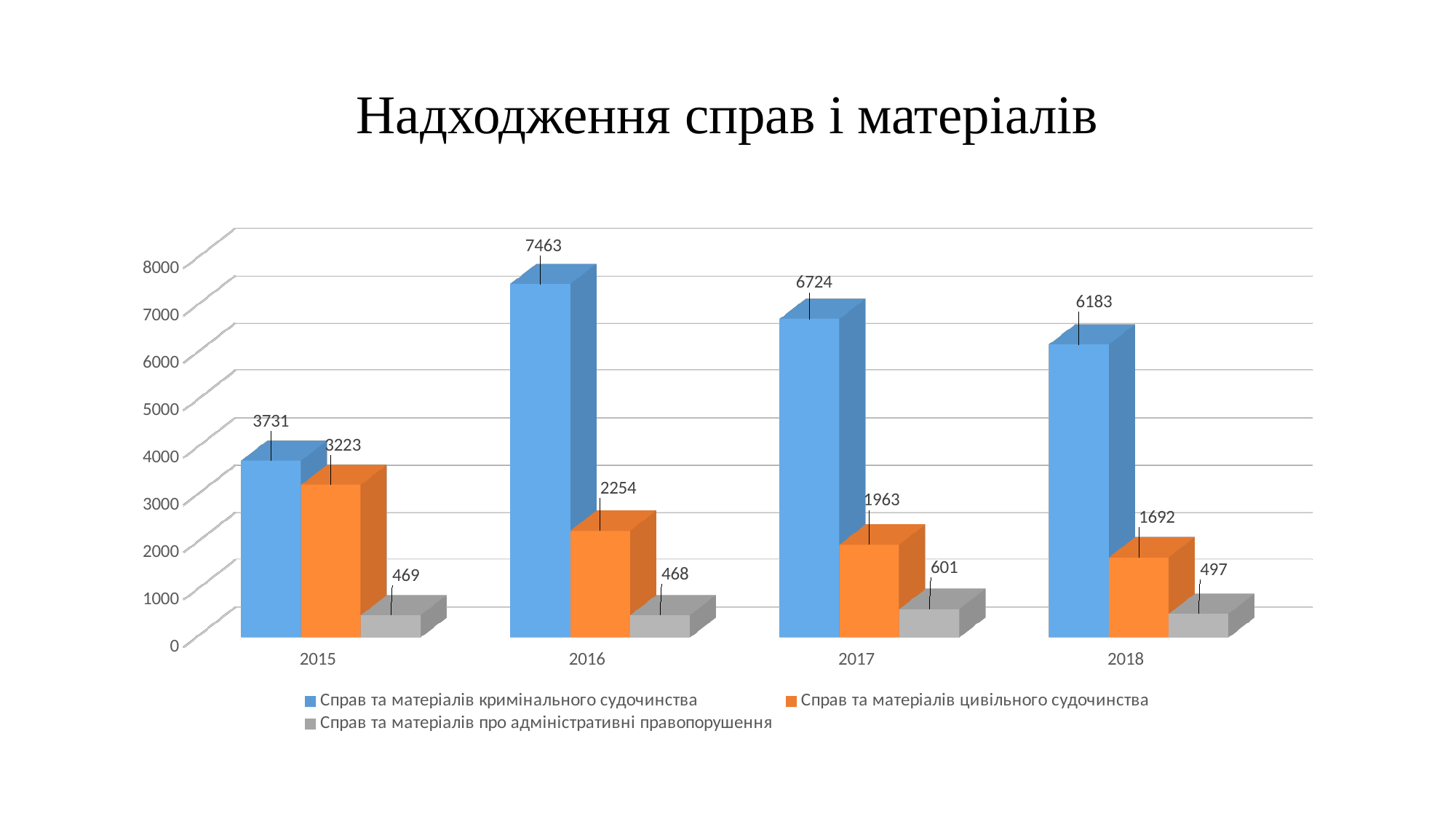
What is the value for 'Справ та матеріалів кримінального судочинства' in 2016? 7463 What is the difference between the 'Справ та матеріалів кримінального судочинства' values for 2016 and 2017? 739 Does the value for 'Справ та матеріалів цивільного судочинства' rise or fall from 2015 to 2018? fall Which is larger: 'Справ та матеріалів цивільного судочинства' in 2015 or in 2016? 2015 Is the value for 'Справ та матеріалів кримінального судочинства' in 2018 greater or less than 5000? greater In which year is the value for 'Справ та матеріалів цивільного судочинства' lowest? 2018 How many years are shown on the x axis? 4 How many series does the legend list? 3 What is the value for 'Справ та матеріалів цивільного судочинства' in 2018? 1692 What kind of chart is shown on the slide? bar chart What is the value for 'Справ та матеріалів про адміністративні правопорушення' in 2017? 601 In which year is the value for 'Справ та матеріалів кримінального судочинства' highest? 2016